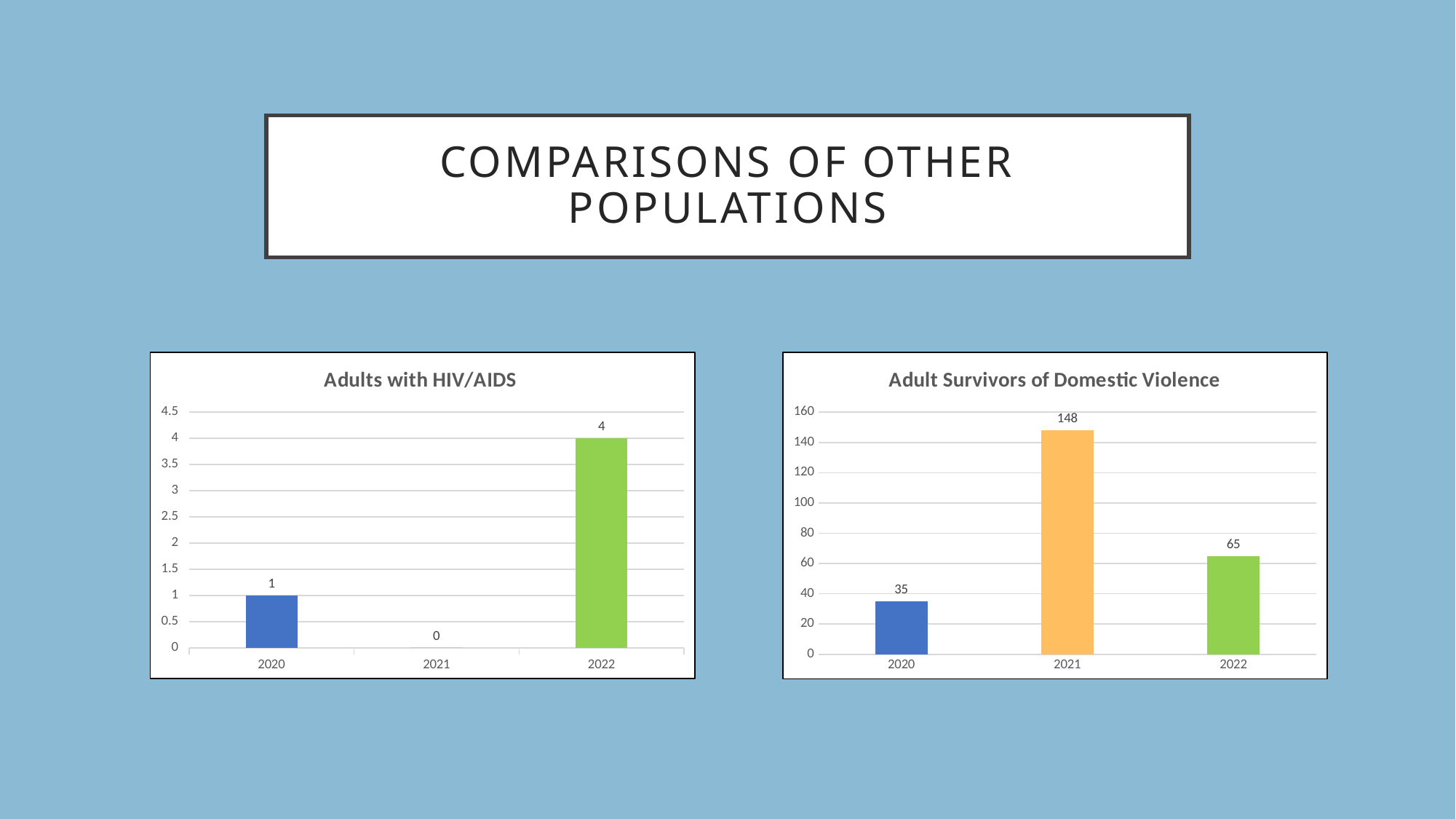
In the 'Adults with HIV/AIDS' chart, which year has the lowest value? 2021 What kind of chart is the 'Adult Survivors of Domestic Violence' chart? Bar chart In the 'Adult Survivors of Domestic Violence' chart, which is larger, the value for 2020 or the value for 2022? 2022 In the 'Adult Survivors of Domestic Violence' chart, is the value for 2021 greater or less than 140? greater In the 'Adults with HIV/AIDS' chart, what is the difference between the values for 2022 and 2020? 3 In the 'Adults with HIV/AIDS' chart, what is the value for 2021? 0 In the 'Adult Survivors of Domestic Violence' chart, what is the value for 2020? 35 In the 'Adults with HIV/AIDS' chart, what is the value for 2022? 4 In the 'Adult Survivors of Domestic Violence' chart, what is the difference between the values for 2021 and 2022? 83 In the 'Adult Survivors of Domestic Violence' chart, what is the value for 2021? 148 In the 'Adult Survivors of Domestic Violence' chart, which year has the highest value? 2021 How many years are shown on the x axis of the 'Adults with HIV/AIDS' chart? 3